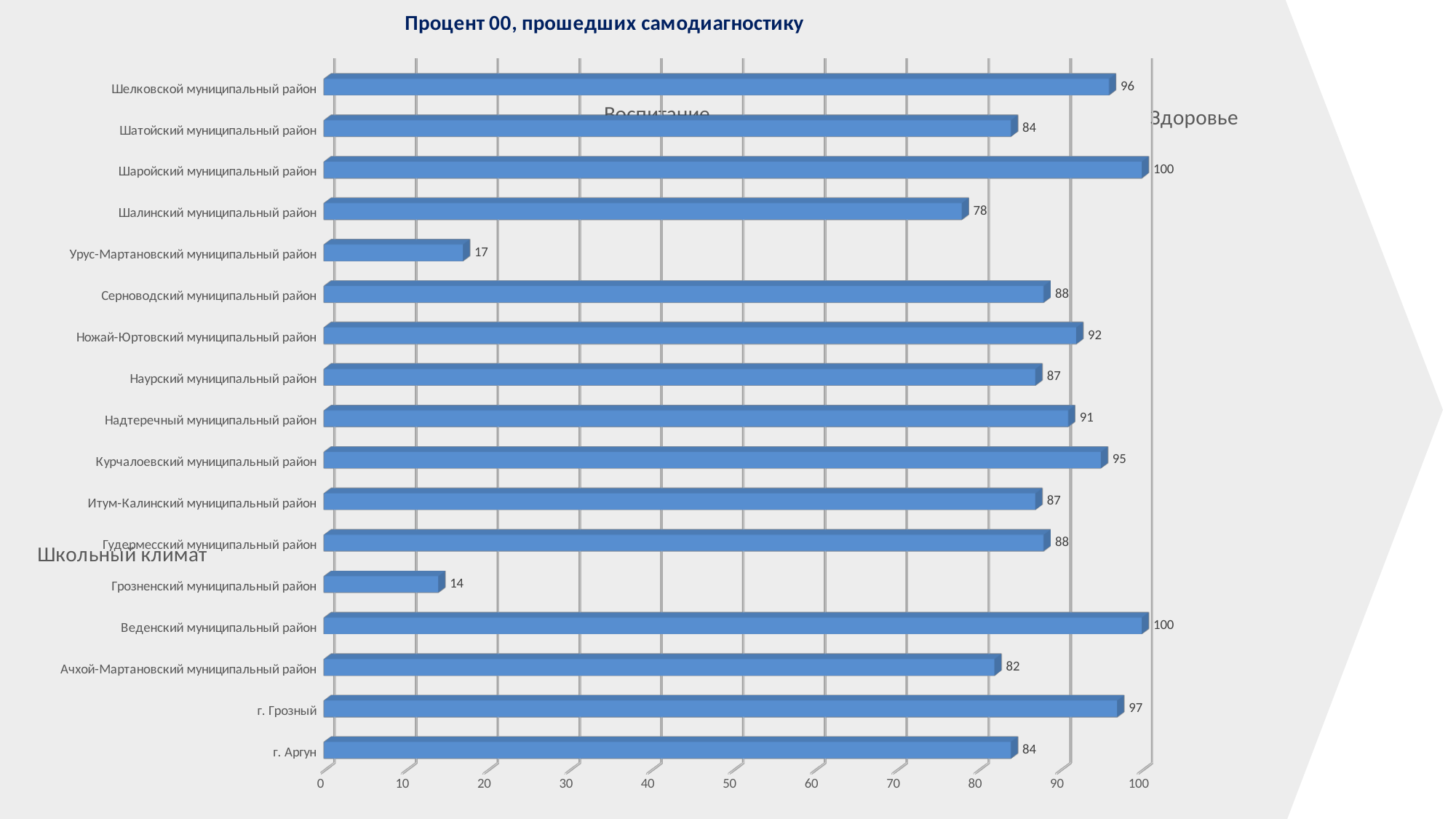
What is the value for Веденский муниципальный район? 100 What is the difference between the values for Курчалоевский муниципальный район and Шалинский муниципальный район? 17 Is the value for Шатойский муниципальный район greater or less than 90? less What is the value for Урус-Мартановский муниципальный район? 17 What is the value for Шелковской муниципальный район? 96 What type of chart is shown on the slide? Bar chart What is the value for г. Грозный? 97 What is the value for Ачхой-Мартановский муниципальный район? 82 Which category has the lowest value? Грозненский муниципальный район What is the title of the chart? Процент 00, прошедших самодиагностику Which is larger, the value for Ножай-Юртовский муниципальный район or the value for Надтеречный муниципальный район? Ножай-Юртовский муниципальный район How many categories are plotted in the chart? 17